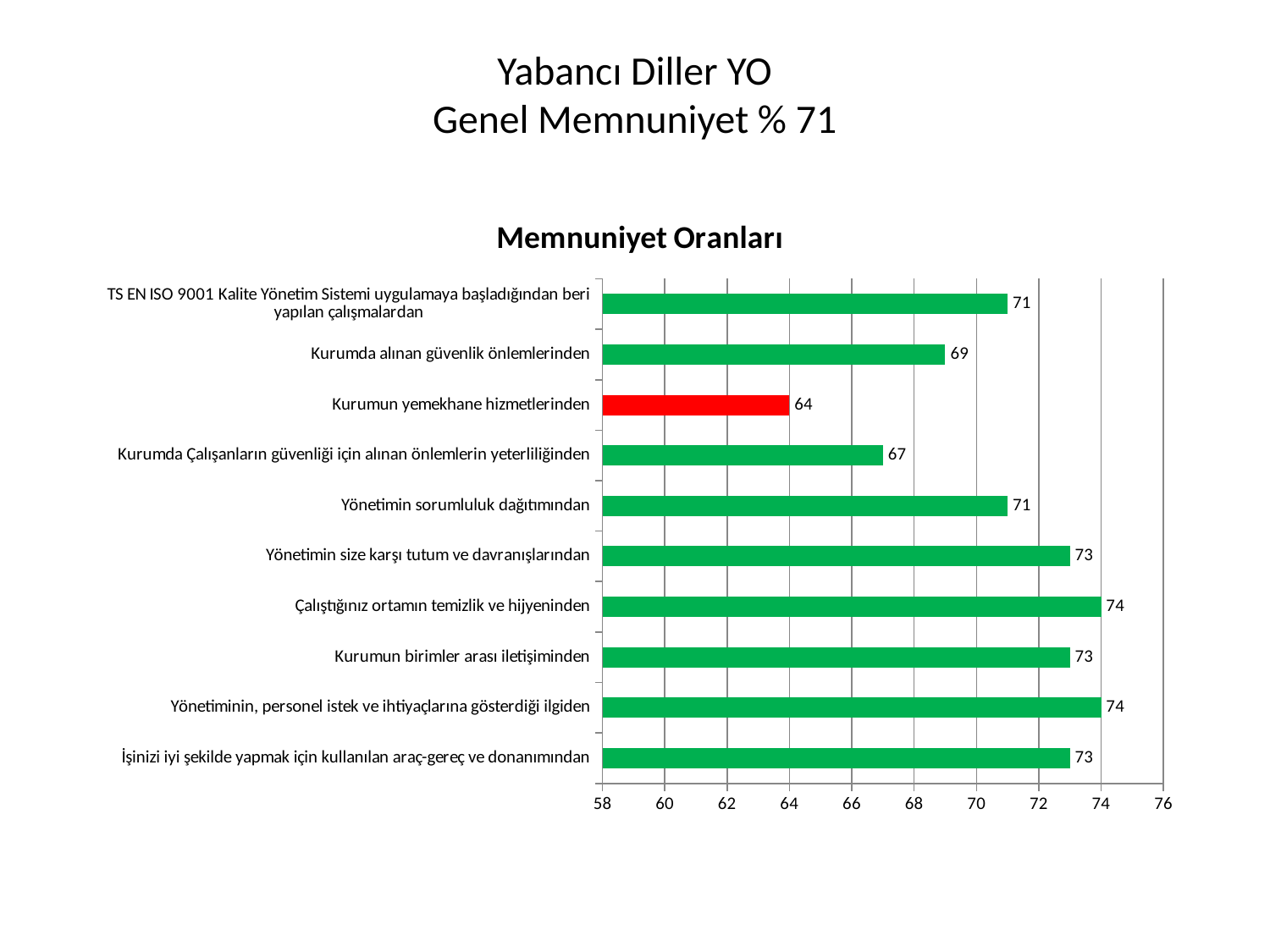
What is the difference between the values for "Çalıştığınız ortamın temizlik ve hijyeninden" and "Kurumun yemekhane hizmetlerinden"? 10 What is the difference between the values for "Kurumda alınan güvenlik önlemlerinden" and "Kurumda Çalışanların güvenliği için alınan önlemlerin yeterliliğinden"? 2 How many categories are shown in the chart? 10 Which category has the lowest value? Kurumun yemekhane hizmetlerinden Which is larger: the value for "Yönetimin size karşı tutum ve davranışlarından" or the value for "Yönetimin sorumluluk dağıtımından"? Yönetimin size karşı tutum ve davranışlarından What is the value for "Çalıştığınız ortamın temizlik ve hijyeninden"? 74 What is the value for "Kurumda Çalışanların güvenliği için alınan önlemlerin yeterliliğinden"? 67 What is the value for "Kurumda alınan güvenlik önlemlerinden"? 69 What is the title of the chart? Memnuniyet Oranları What kind of chart is shown on the slide? bar chart What is the value for "Kurumun yemekhane hizmetlerinden"? 64 Is the value for "Kurumun yemekhane hizmetlerinden" greater or less than 70? less